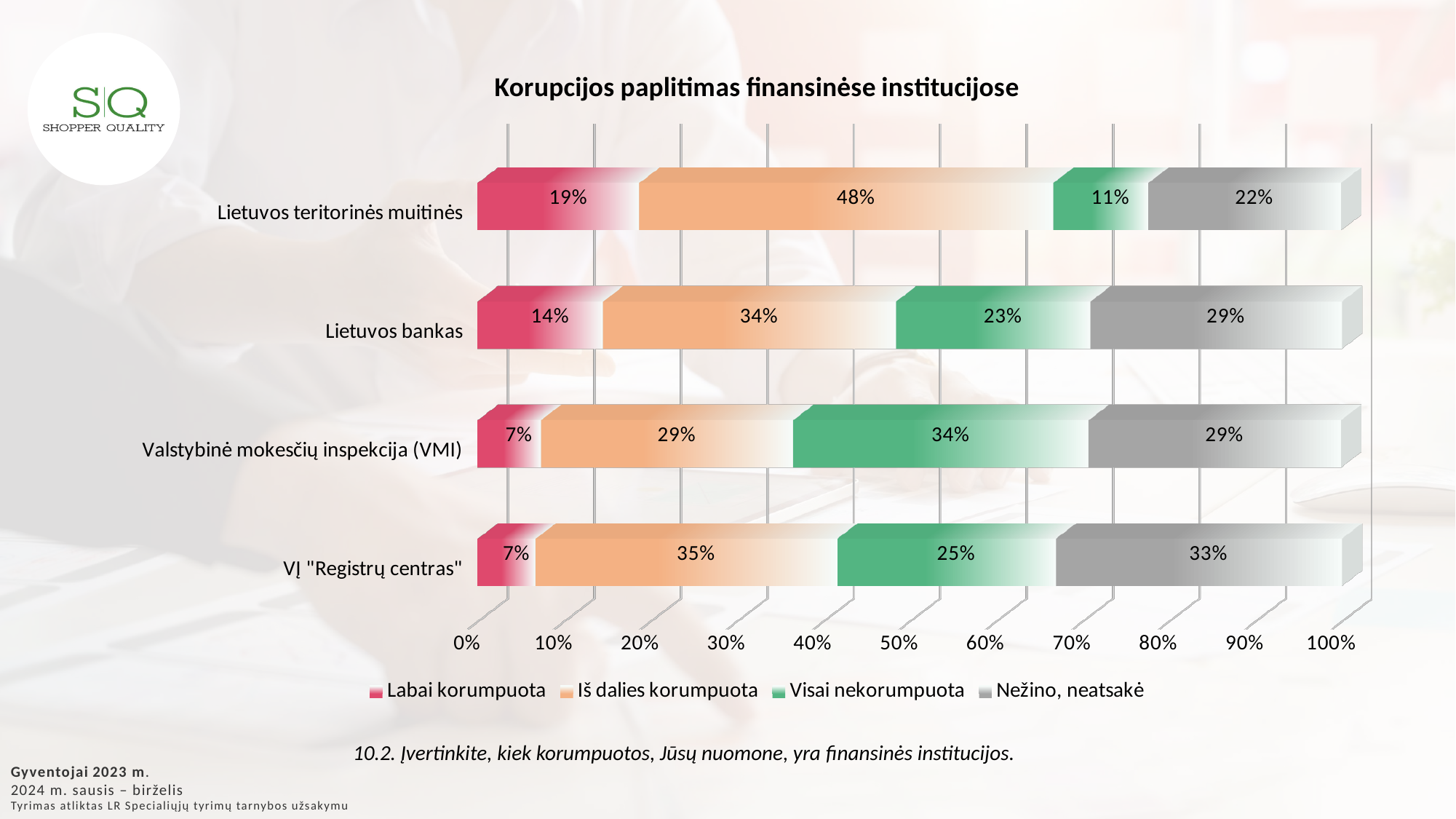
Which institution has the highest "Labai korumpuota" share? Lietuvos teritorinės muitinės What is the difference between the "Iš dalies korumpuota" values for Lietuvos teritorinės muitinės and Valstybinė mokesčių inspekcija (VMI)? 19 percentage points What is the title of the chart? Korupcijos paplitimas finansinėse institucijose What is the "Visai nekorumpuota" value for Lietuvos bankas? 23% What percentage of respondents rated Lietuvos teritorinės muitinės as "Iš dalies korumpuota"? 48% Which institution has the lowest "Visai nekorumpuota" share? Lietuvos teritorinės muitinės What is the "Nežino, neatsakė" value for VĮ "Registrų centras"? 33% What type of chart is shown on the slide? Stacked bar chart What is the combined share of "Labai korumpuota" and "Iš dalies korumpuota" for Lietuvos bankas? 48% How many series does the legend list? 4 Which is larger: the "Visai nekorumpuota" value for Valstybinė mokesčių inspekcija (VMI) or for VĮ "Registrų centras"? Valstybinė mokesčių inspekcija (VMI) How many institutions are shown on the chart? 4